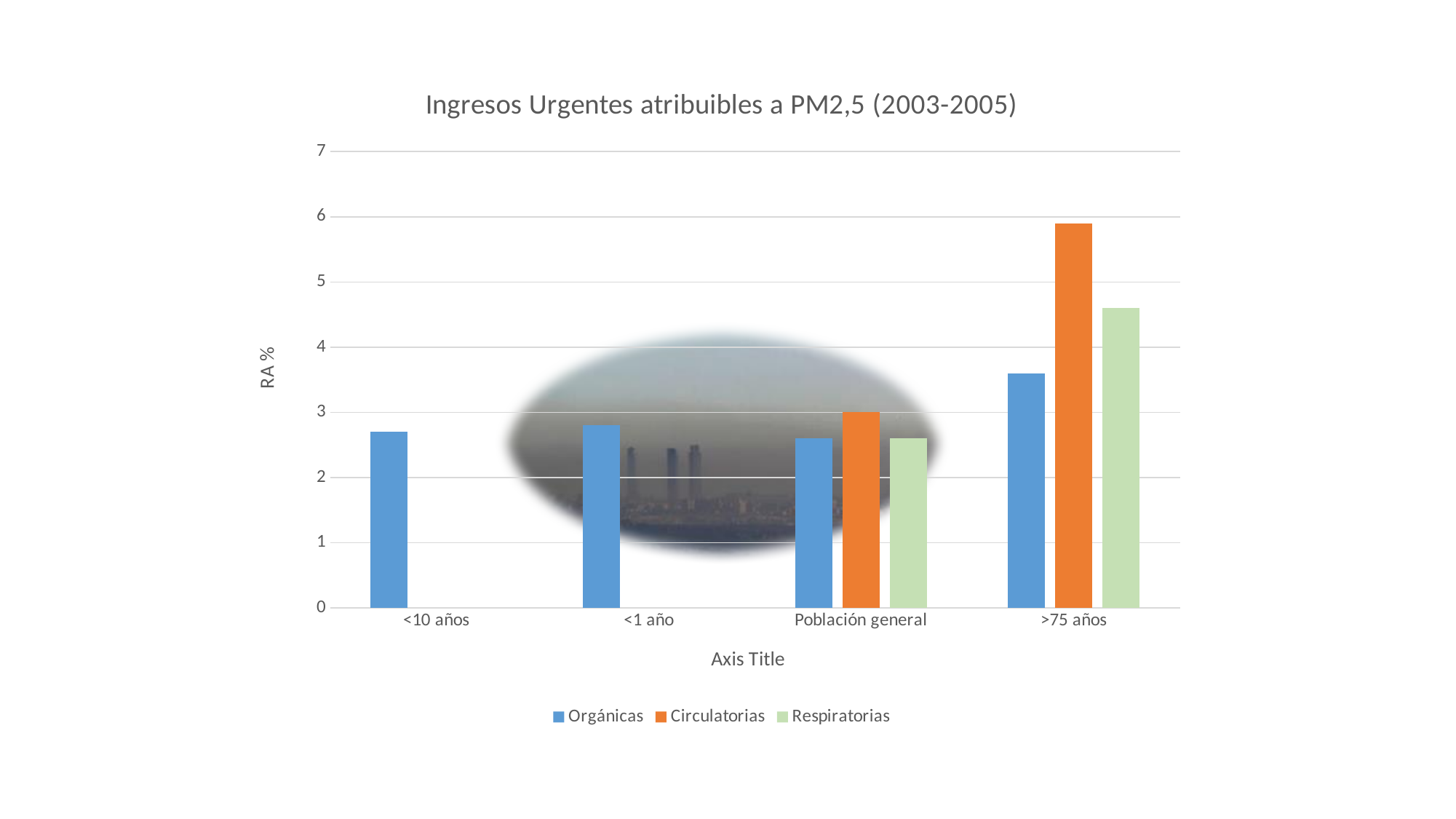
Which category has the highest value for Circulatorias? >75 años Is the value for Orgánicas in <10 años greater or less than 3? less Which category has the highest value for Orgánicas? >75 años What kind of chart is shown on the slide? bar chart Is the value for Respiratorias in >75 años greater or less than 4? greater How many categories are shown on the x axis? 4 For Población general, which is larger: Circulatorias or Orgánicas? Circulatorias How many categories have a Respiratorias bar? 2 For >75 años, which is larger: Circulatorias or Respiratorias? Circulatorias Is the value for Circulatorias in >75 años greater or less than 5? greater What is the title of the vertical axis? RA % How many series does the legend list? 3